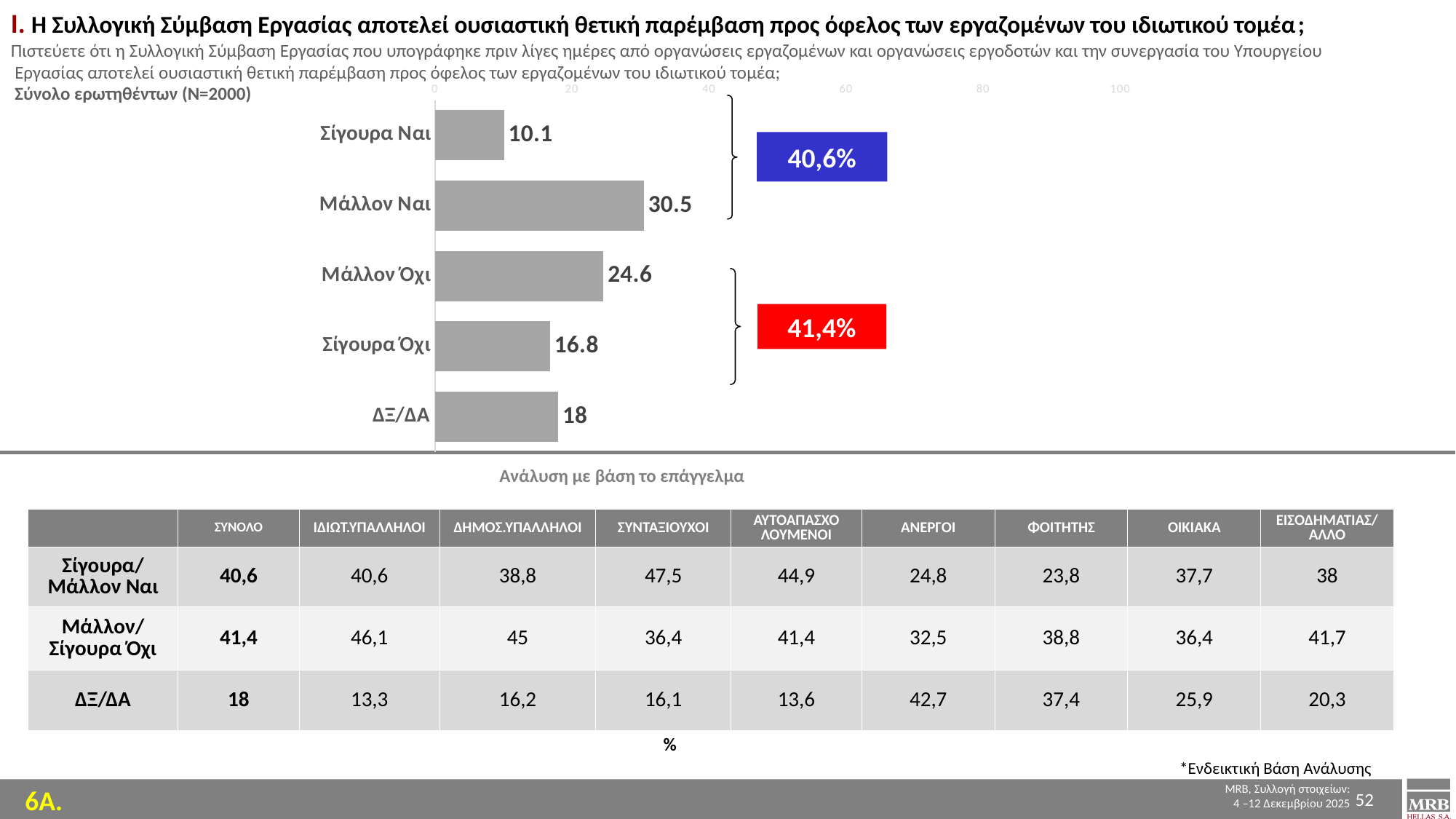
Is the value for Μάλλον Όχι in the bar chart greater or less than 20? greater What value is shown for Μάλλον Ναι in the bar chart? 30.5 What is the difference between the values for Μάλλον Ναι and Μάλλον Όχι in the bar chart? 5.9 How many categories are shown in the bar chart? 5 What percentage is shown in the red box next to the bar chart? 41,4% What value is shown for ΔΞ/ΔΑ in the bar chart? 18 Which is larger in the bar chart: the value for Σίγουρα Όχι or the value for ΔΞ/ΔΑ? ΔΞ/ΔΑ What value is shown for Σίγουρα Όχι in the bar chart? 16.8 What is the combined total of Σίγουρα Ναι and Μάλλον Ναι in the bar chart? 40.6 Which category has the lowest value in the bar chart? Σίγουρα Ναι What kind of chart is shown on the slide? Bar chart Which category has the highest value in the bar chart? Μάλλον Ναι